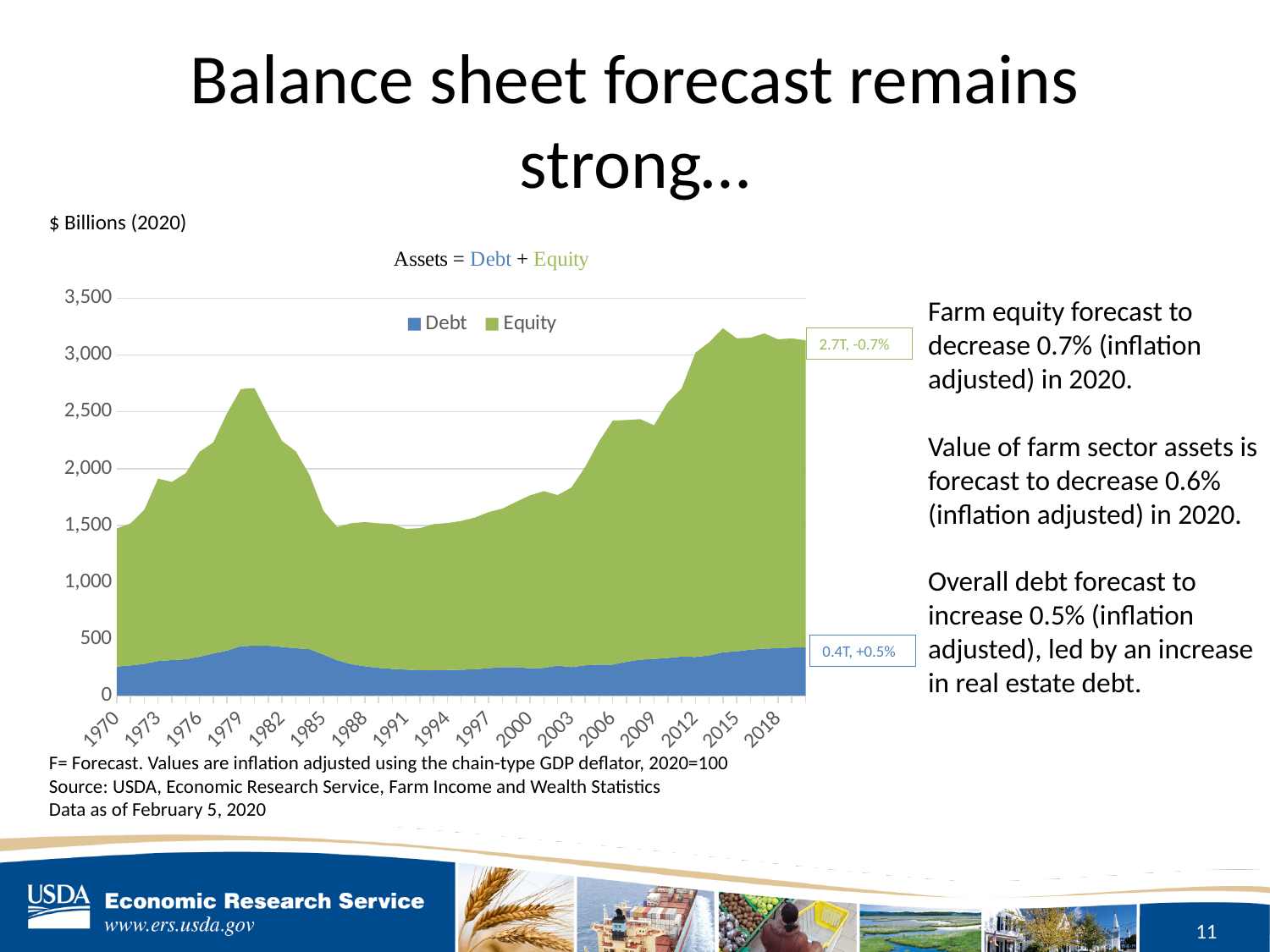
What kind of chart is shown on the slide? stacked area chart What label is shown at the right end of the Debt area? 0.4T, +0.5% How many year labels are shown on the x axis? 17 Is the total of Debt plus Equity in 1980 greater or less than 2,500? greater Is the total of Debt plus Equity in 2006 greater or less than 2,000? greater What is the title printed above the chart? Assets = Debt + Equity Is the value for Debt in 1970 greater or less than 500? less Which series, Debt or Equity, is larger in 2018? Equity What label is shown at the right end of the Equity area? 2.7T, -0.7% What are the two series named in the chart legend? Debt and Equity How many series does the chart legend list? 2 Does the total of Debt plus Equity rise or fall between 1980 and 1986? fall